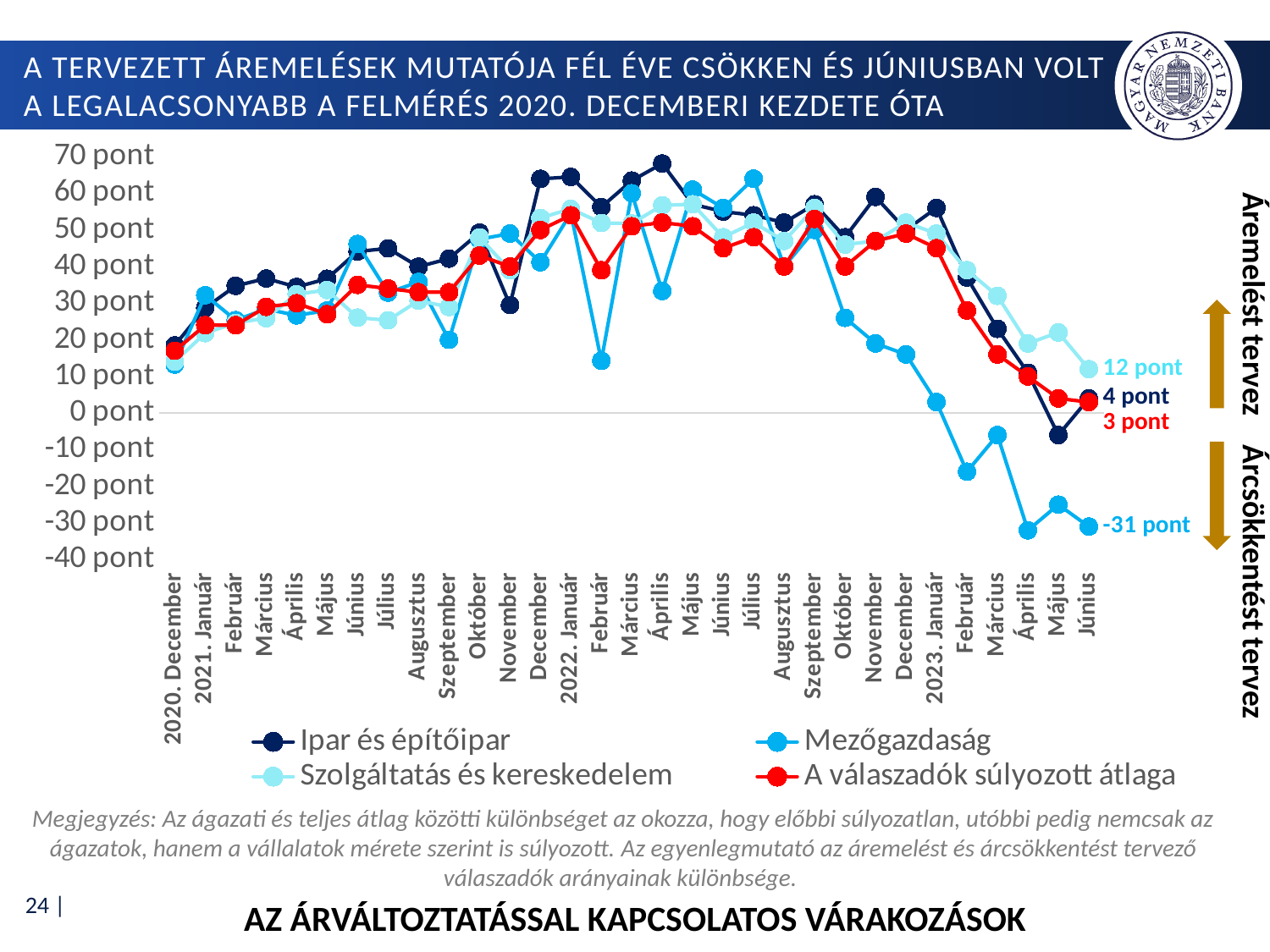
Which series has the lowest value in 2023 Június? Mezőgazdaság What is the value for Ipar és építőipar in 2023 Június? 4 pont What kind of chart is shown on the slide? line chart What is the value for A válaszadók súlyozott átlaga in 2023 Június? 3 pont How many series does the legend list? 4 What is the value for Szolgáltatás és kereskedelem in 2023 Június? 12 pont Does the value of A válaszadók súlyozott átlaga rise or fall from 2023 Január to 2023 Június? fall Is the value for Mezőgazdaság in 2023 Február greater or less than -10 pont? less What is the value for Mezőgazdaság in 2023 Június? -31 pont What is the difference between the 2023 Június values of Szolgáltatás és kereskedelem and Mezőgazdaság? 43 pont Which series has the highest value in 2023 Június? Szolgáltatás és kereskedelem In 2023 Június, which is larger: Ipar és építőipar or A válaszadók súlyozott átlaga? Ipar és építőipar